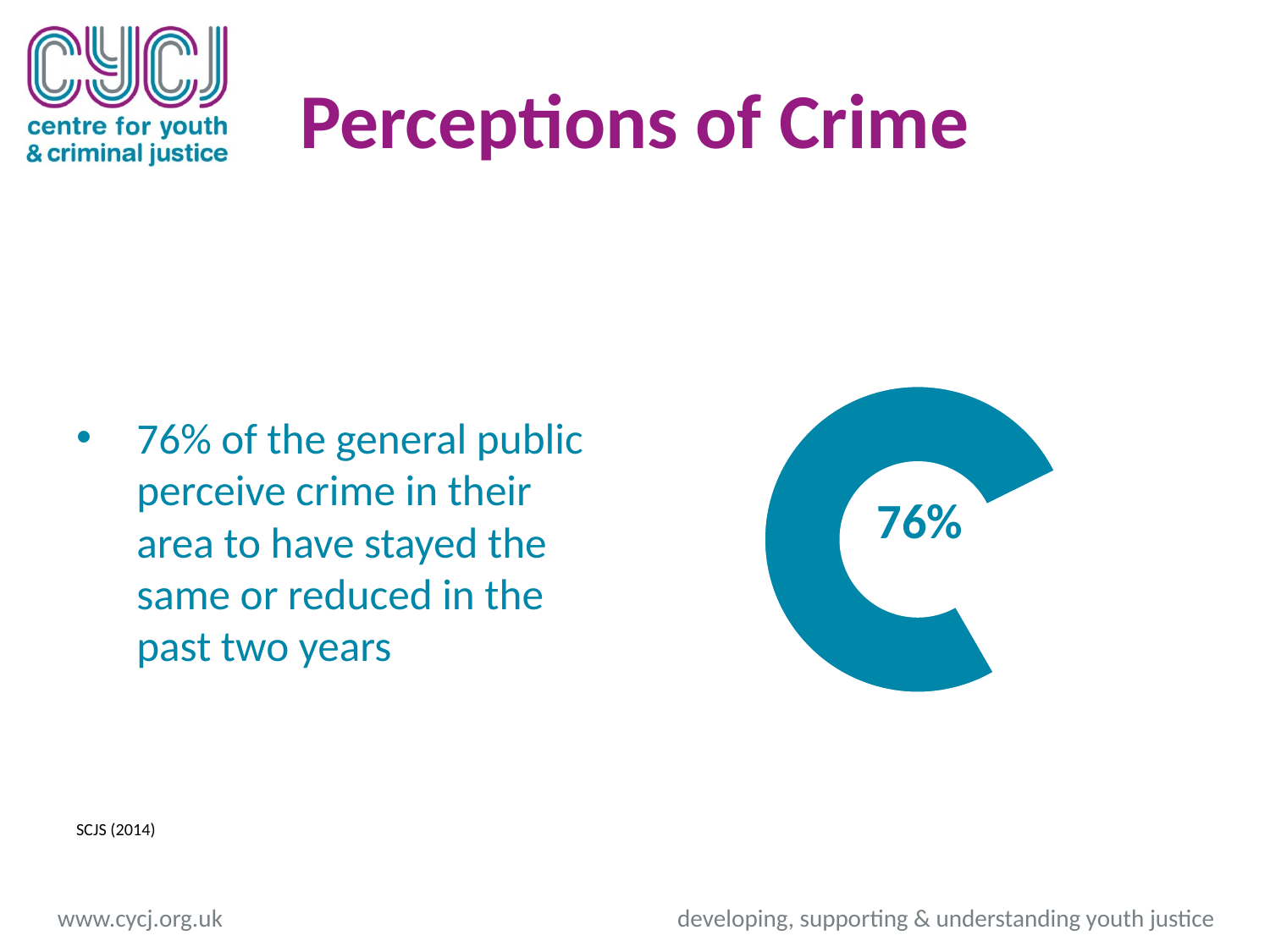
What share of the doughnut chart does the filled blue segment represent? 76% What colour is the filled segment of the doughnut chart? blue What share of the doughnut is left unfilled by the blue segment? 24% Is the value shown in the doughnut chart greater or less than 50%? greater According to the slide, what percentage of the general public perceive crime in their area to have stayed the same or reduced in the past two years? 76% What kind of chart is shown on the slide? doughnut chart What percentage is printed in the centre of the doughnut chart? 76% What is the title of the slide containing the doughnut chart? Perceptions of Crime